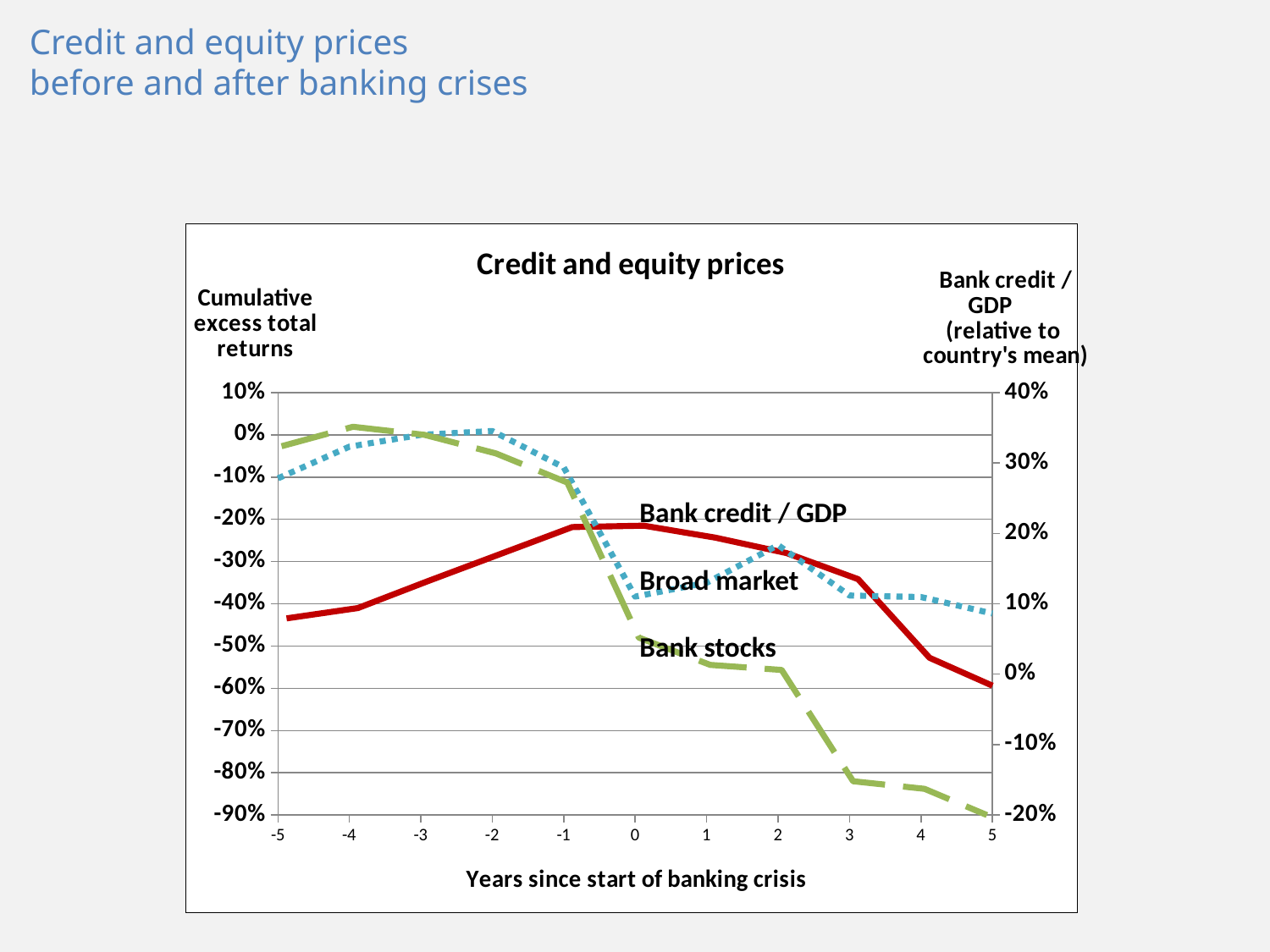
Which series is plotted against the right-hand axis (Bank credit / GDP relative to country's mean)? Bank credit / GDP Do the Bank stocks values rise or fall from year 0 to year 5? fall Is the value for Bank stocks at year -4 greater or less than -10%? greater How many points along the x axis (years) does each line cover? 11 Is the value for Bank stocks at year 3 greater or less than -70%? less How many series are plotted on the chart? 3 What is the title of the x axis? Years since start of banking crisis Is the value for Broad market at year 0 greater or less than -30%? less What kind of chart is shown on the slide? line chart At year 5, which is higher on the left axis: Broad market or Bank stocks? Broad market